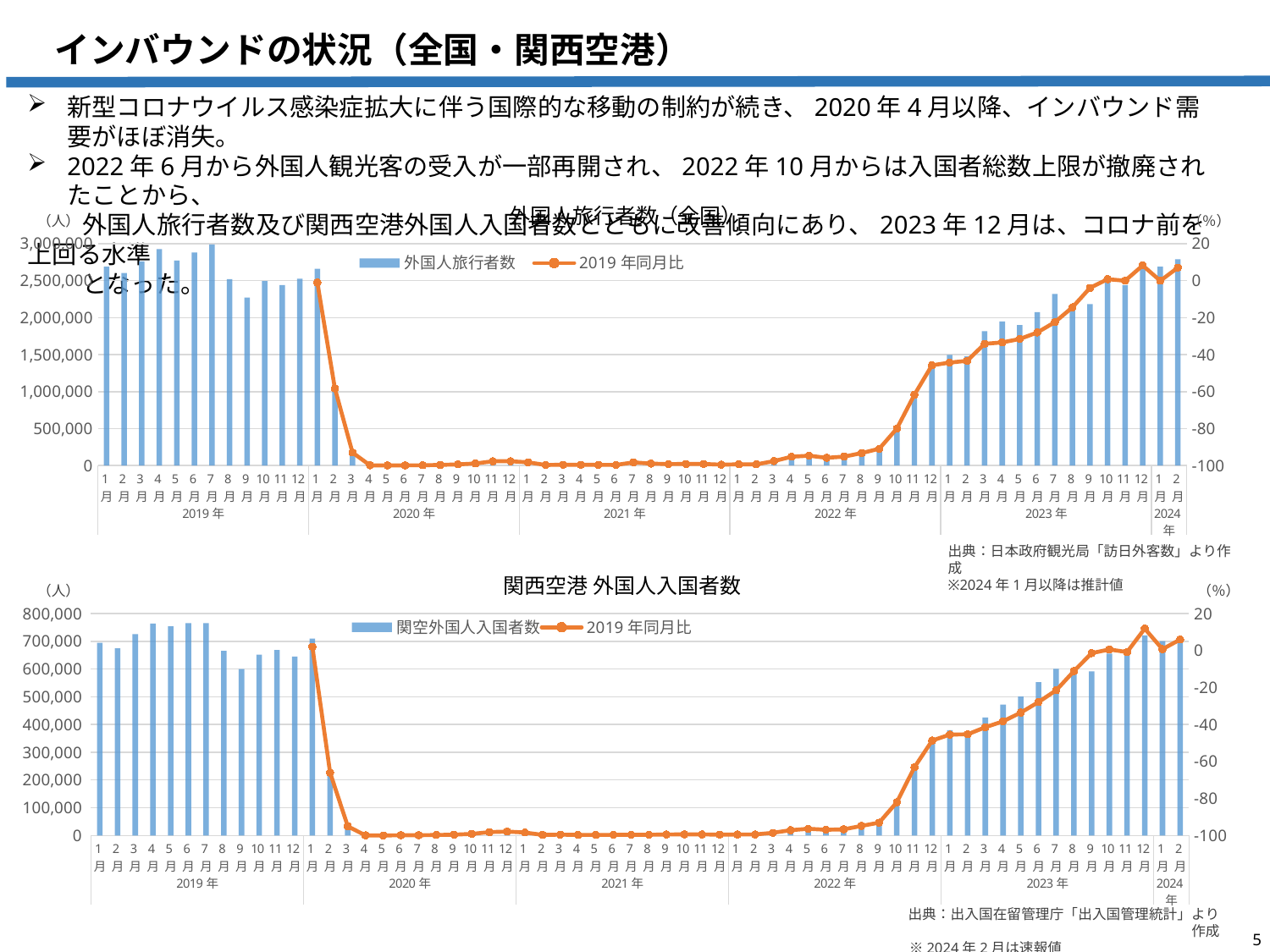
In the top chart 外国人旅行者数（全国）, is the bar for 2019年1月 greater or less than 2,500,000? greater In the top chart 外国人旅行者数（全国）, what are the two legend entries? 外国人旅行者数 and 2019年同月比 In the bottom chart 関西空港 外国人入国者数, is the bar for 2020年5月 greater or less than 100,000? less In the bottom chart 関西空港 外国人入国者数, is the bar for 2019年1月 greater or less than 600,000? greater In the bottom chart 関西空港 外国人入国者数, which bar is larger: 2022年12月 or 2023年12月? 2023年12月 In the top chart 外国人旅行者数（全国）, which bar is larger: 2019年7月 or 2020年7月? 2019年7月 In the bottom chart 関西空港 外国人入国者数, do the bars rise or fall from 2022年6月 to 2023年12月? rise What kind of chart is the top chart titled 外国人旅行者数（全国）? A bar chart combined with a line In the bottom chart 関西空港 外国人入国者数, what is the name of the bar series in the legend? 関空外国人入国者数 How many series does the legend of the bottom chart 関西空港 外国人入国者数 list? 2